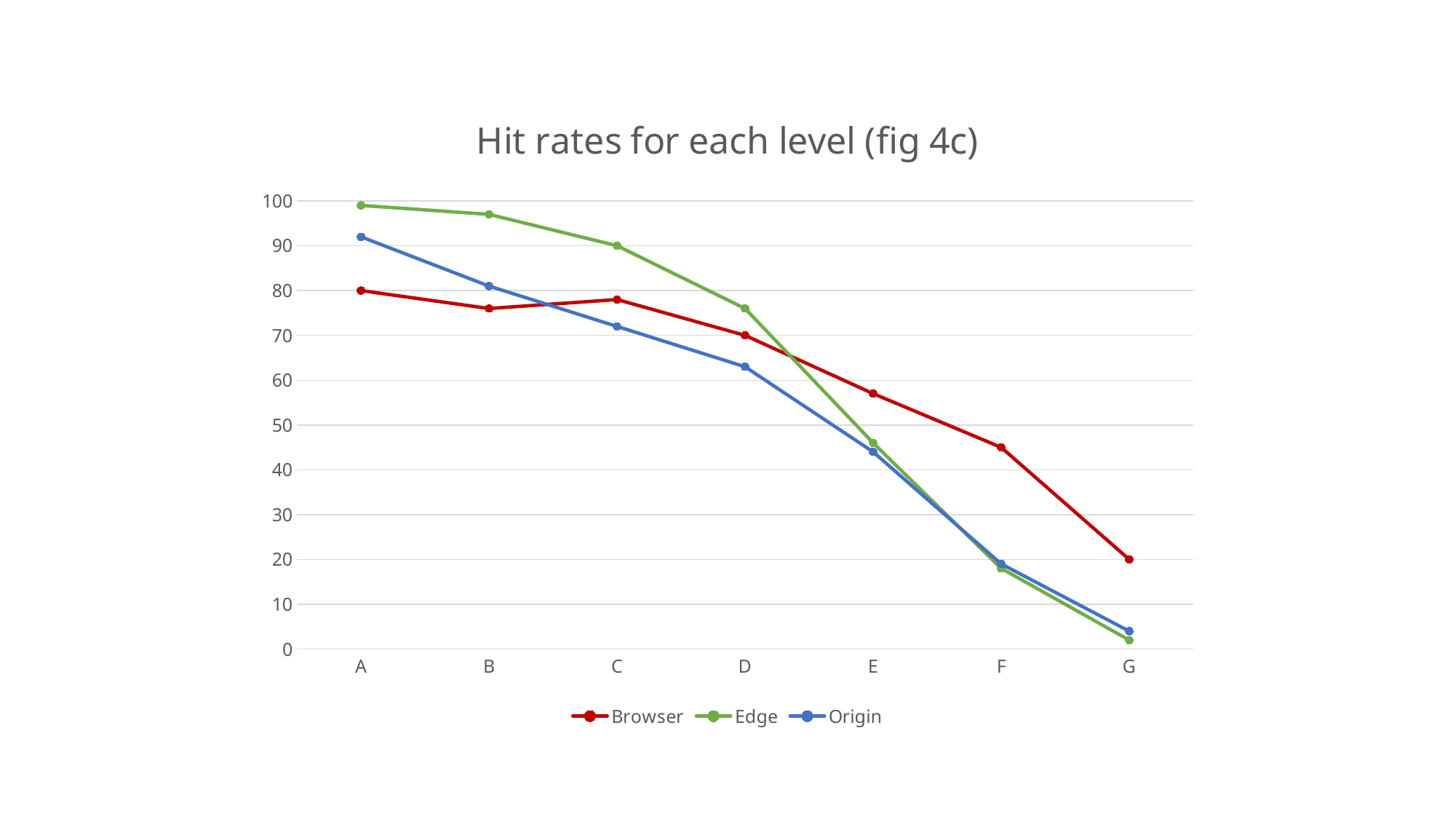
Is the Edge value at level A greater or less than 90? greater Which series has the highest hit rate at level G? Browser Is the Browser value at level F greater or less than 50? less What is the title of the chart? Hit rates for each level (fig 4c) How many levels are shown on the x axis? 7 Does the Edge series rise or fall from level A to level G? fall What is the Browser hit rate at level A? 80 What is the Edge hit rate at level C? 90 Is the Origin value at level G greater or less than 10? less How many series does the legend list? 3 What kind of chart is shown on the slide? line chart Which series has the highest hit rate at level A? Edge